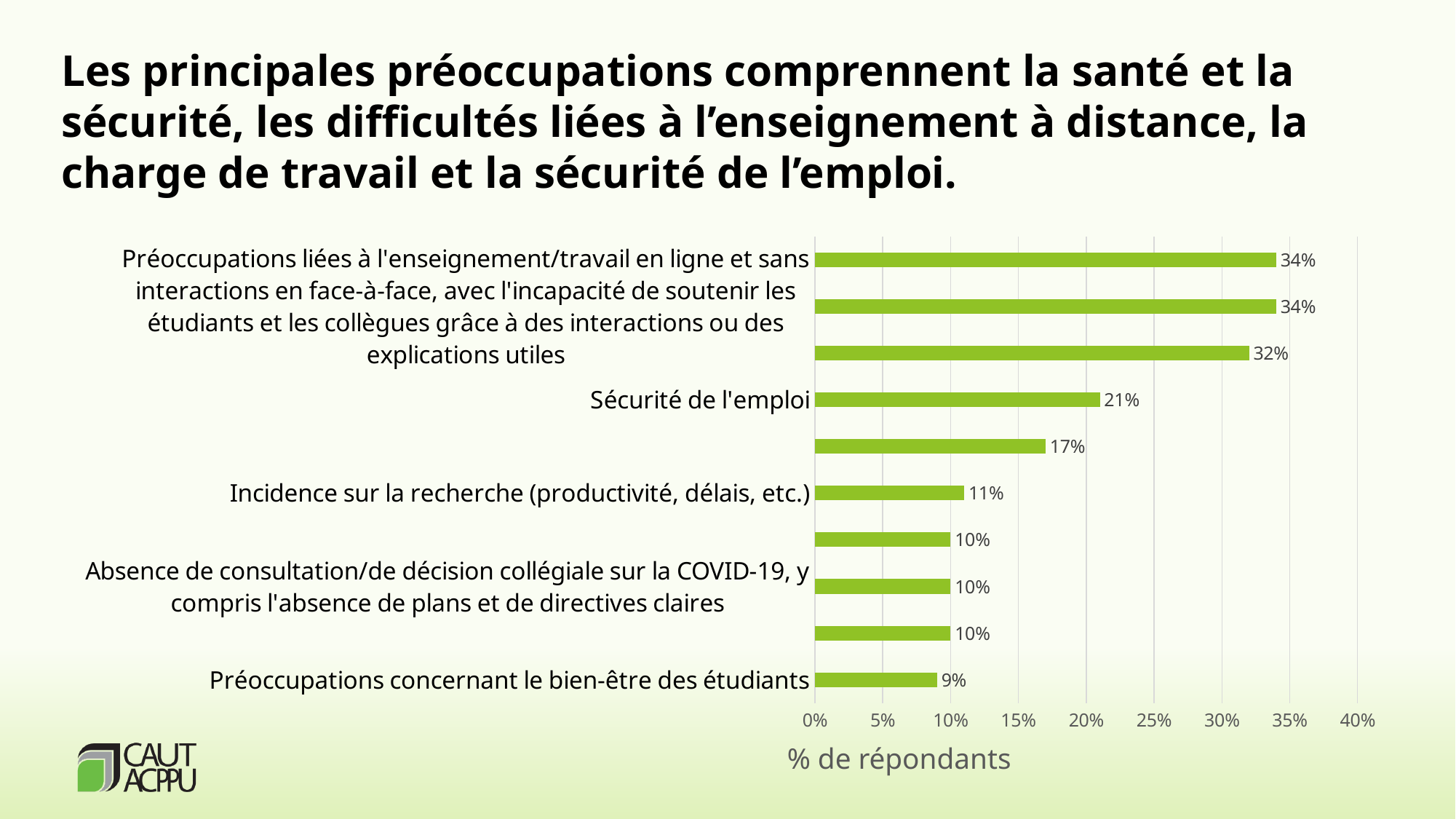
What is the title of the horizontal axis? % de répondants What percentage of respondents cited 'Préoccupations concernant le bien-être des étudiants'? 9% What is the highest percentage value shown on the chart? 34% What is the value for 'Incidence sur la recherche (productivité, délais, etc.)'? 11% Which labelled category has the lowest percentage of respondents? Préoccupations concernant le bien-être des étudiants Which has a higher value: 'Sécurité de l'emploi' or 'Préoccupations concernant le bien-être des étudiants'? Sécurité de l'emploi What is the difference in percentage points between 'Sécurité de l'emploi' and 'Incidence sur la recherche (productivité, délais, etc.)'? 10 percentage points How many bars are plotted on the chart? 10 What percentage of respondents cited 'Sécurité de l'emploi'? 21% What is the value for 'Absence de consultation/de décision collégiale sur la COVID-19, y compris l'absence de plans et de directives claires'? 10% What is the value for the concern about online teaching/work without face-to-face interactions ('Préoccupations liées à l'enseignement/travail en ligne...')? 34% What type of chart is shown on the slide? Bar chart